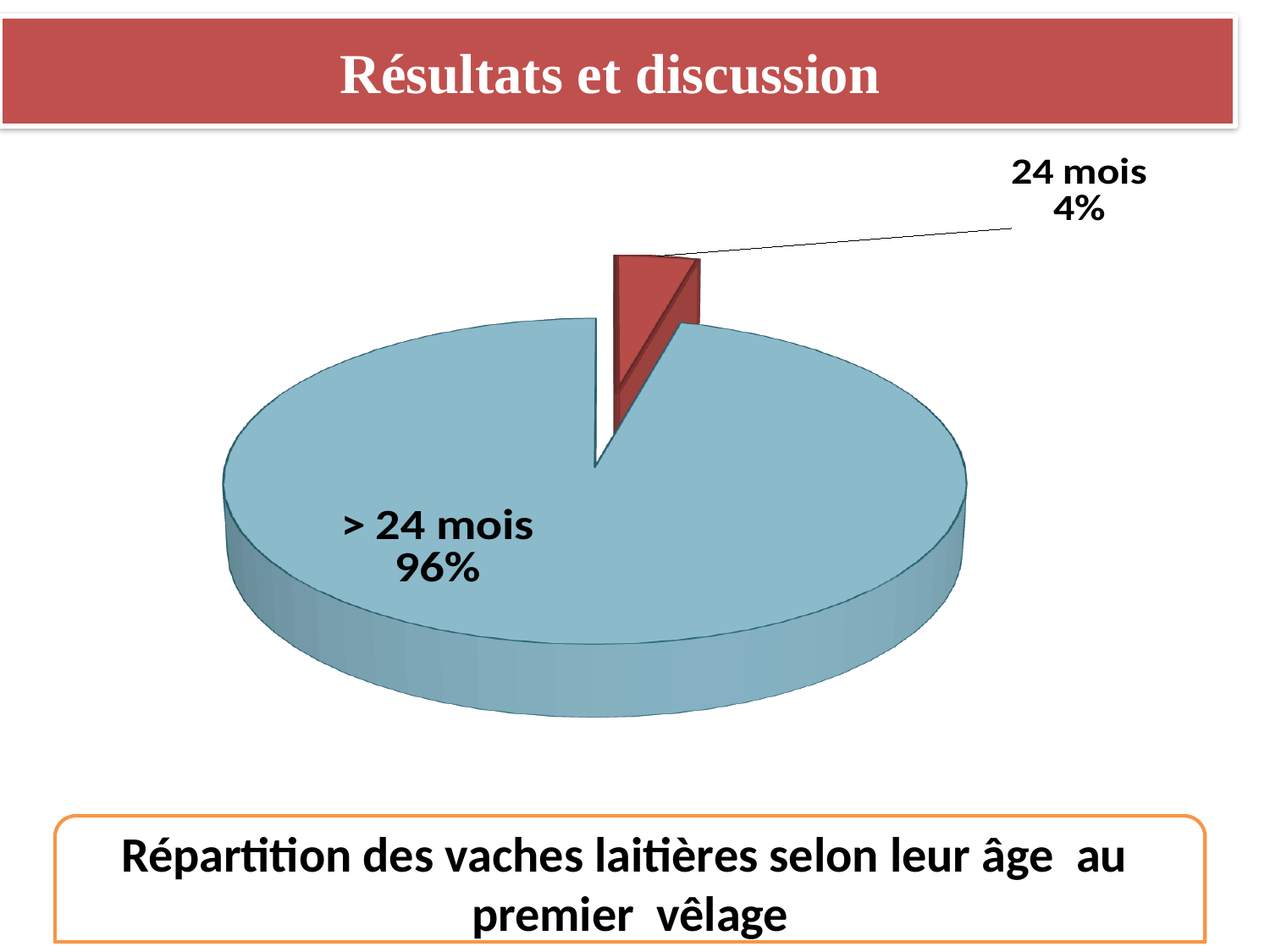
What share of the pie does the "24 mois" slice represent? 4% What kind of chart is shown on the slide? Pie chart What share of the pie does the "> 24 mois" slice represent? 96% Which slice is larger, "24 mois" or "> 24 mois"? > 24 mois What is the caption below the chart? Répartition des vaches laitières selon leur âge au premier vêlage How many slices does the pie chart have? 2 What colour is the "24 mois" slice? Red Which category has the smallest share of the pie? 24 mois Which category has the largest share of the pie? > 24 mois What is the difference in percentage points between the "> 24 mois" and "24 mois" slices? 92